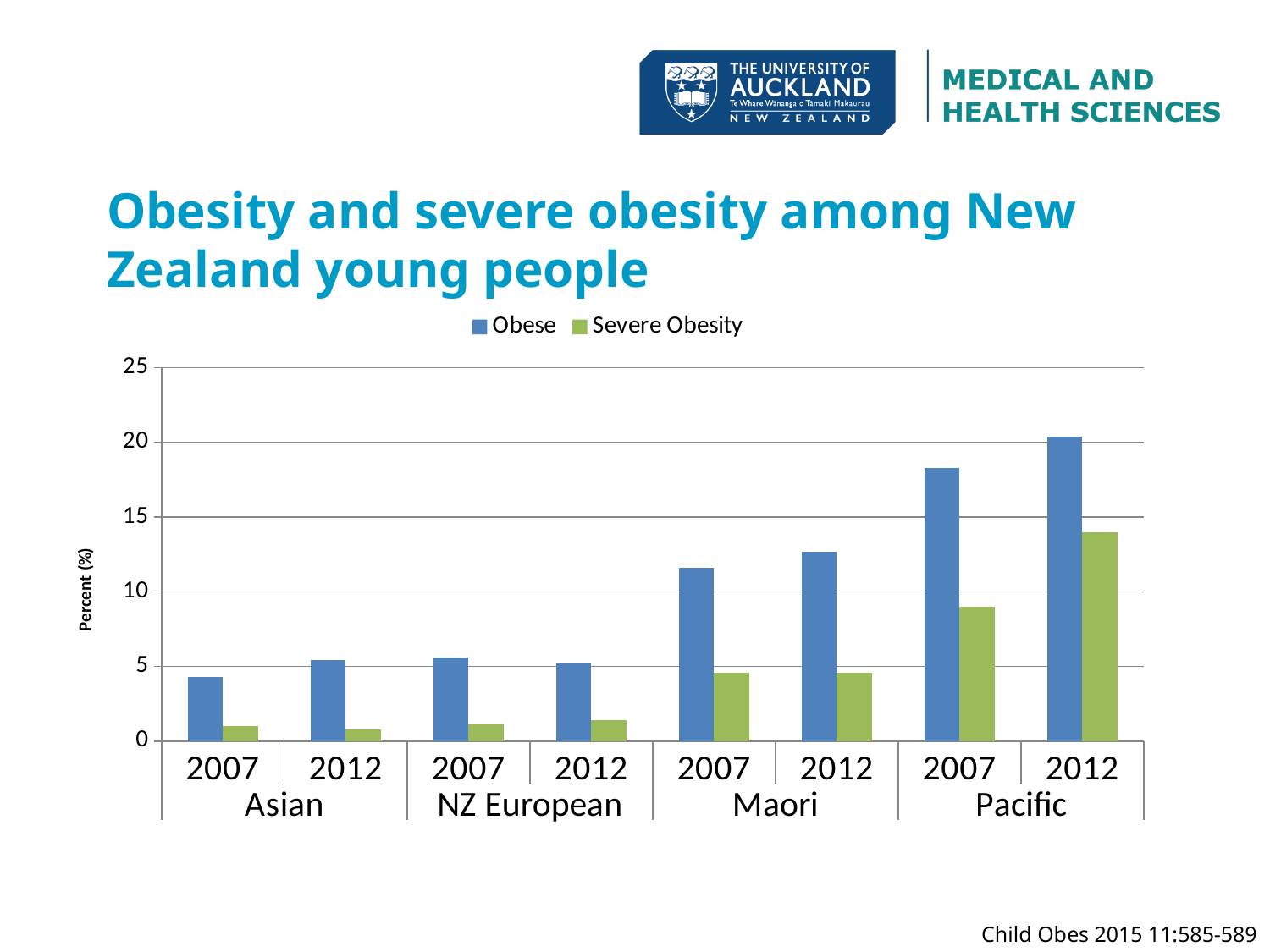
How many ethnic groups are shown on the x axis? 4 Which group and year has the lowest Obese value? Asian 2007 What kind of chart is shown on the slide? Bar chart Is the Obese value for Asian 2007 greater or less than 5? less How many series does the legend list? 2 Which is larger, the Obese value for Maori 2012 or for NZ European 2012? Maori 2012 Is the Severe Obesity value for Pacific 2012 greater or less than 10? greater What are the two series named in the legend? Obese and Severe Obesity Which group and year has the highest Severe Obesity value? Pacific 2012 Is the Obese value for Pacific 2007 greater or less than 15? greater For Pacific young people, does the Obese value rise or fall from 2007 to 2012? Rise Which group and year has the highest Obese value? Pacific 2012